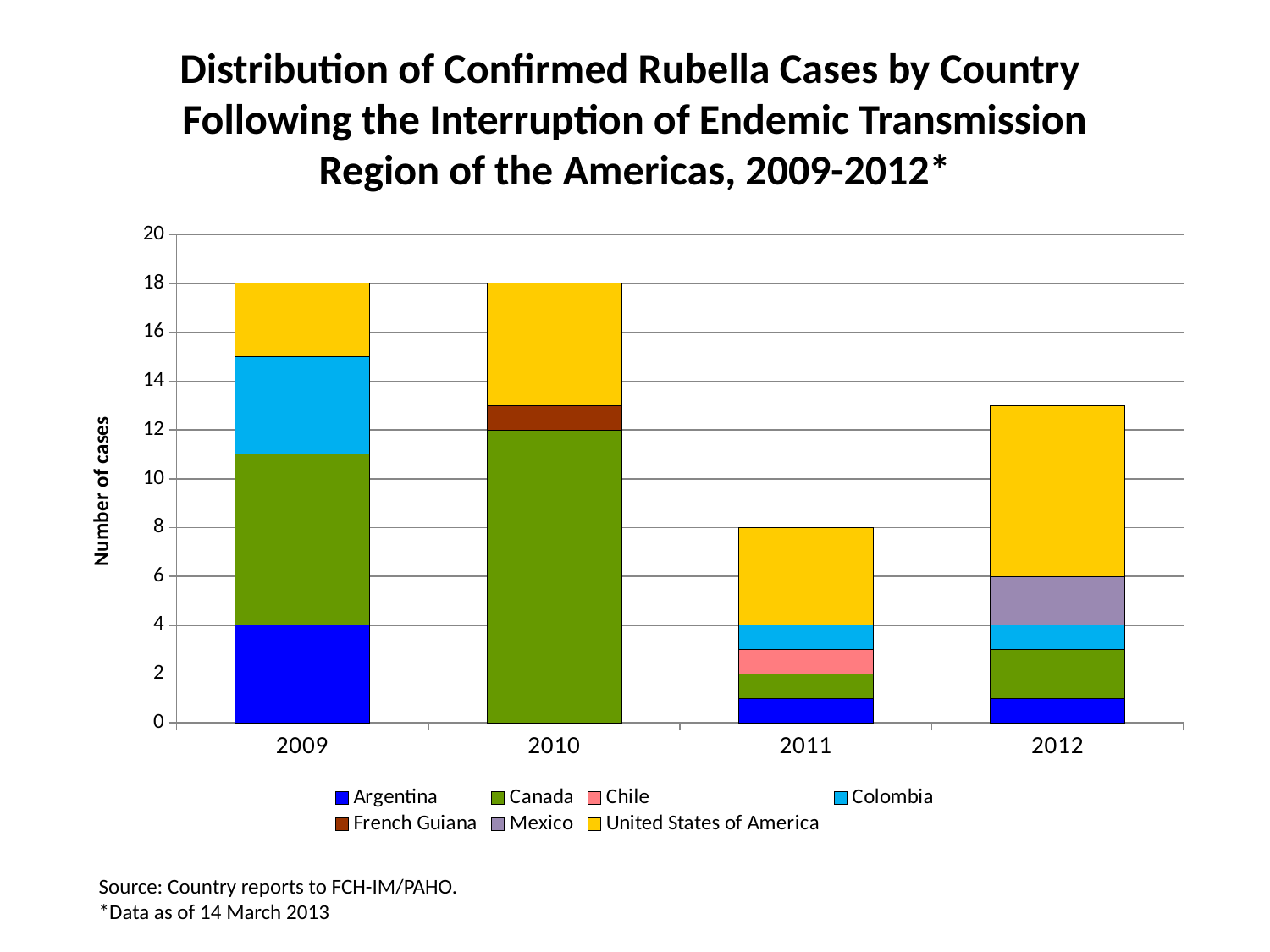
Which year has a higher total number of cases, 2011 or 2012? 2012 How many years are shown on the x axis? 4 How many countries are listed in the legend? 7 What is the total number of confirmed rubella cases in 2009? 18 Which year has the lowest total number of cases? 2011 How many cases does Canada account for in 2010? 12 Is the total number of cases in 2012 greater or less than 12? greater What is the total number of confirmed rubella cases in 2011? 8 What is the label on the y axis? Number of cases What kind of chart is shown on the slide? Stacked bar chart In which year does French Guiana appear in the stacked bar? 2010 How many cases does Argentina account for in 2009? 4